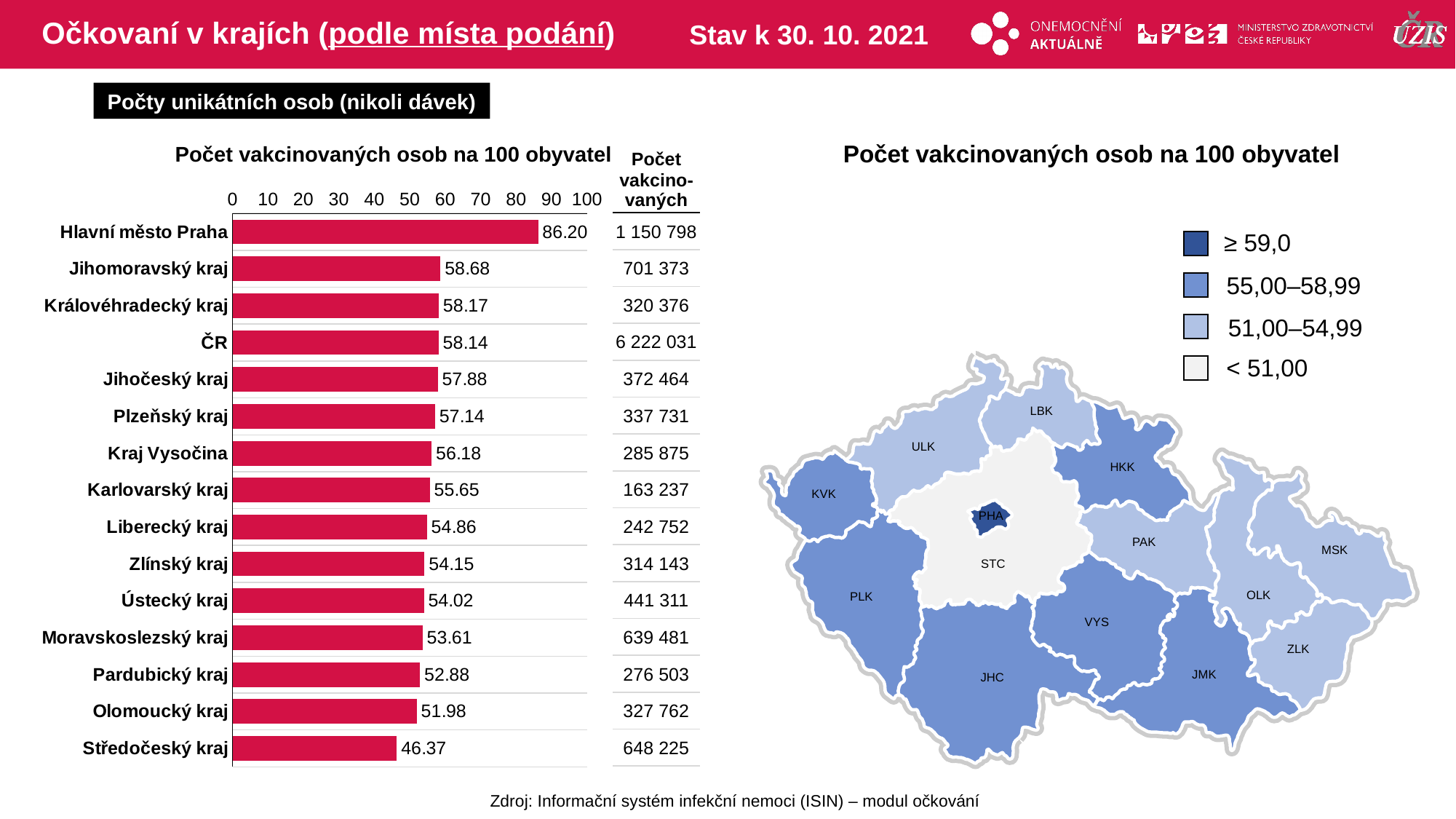
What type of chart is shown on the left of the slide? bar chart In the bar chart, what is the value for ČR? 58.14 In the bar chart, is the value for Hlavní město Praha greater or less than 80? greater In the bar chart, which has a larger value: Plzeňský kraj or Liberecký kraj? Plzeňský kraj What is the title of the bar chart on the left? Počet vakcinovaných osob na 100 obyvatel Which category has the highest value in the bar chart? Hlavní město Praha In the bar chart, what is the value for Hlavní město Praha? 86.20 How many categories are shown in the bar chart? 15 In the bar chart, what is the difference between the values for Hlavní město Praha and Středočeský kraj? 39.83 Which category has the lowest value in the bar chart? Středočeský kraj In the bar chart, do the values rise or fall going from the top bar to the bottom bar? fall In the bar chart, what is the value for Kraj Vysočina? 56.18